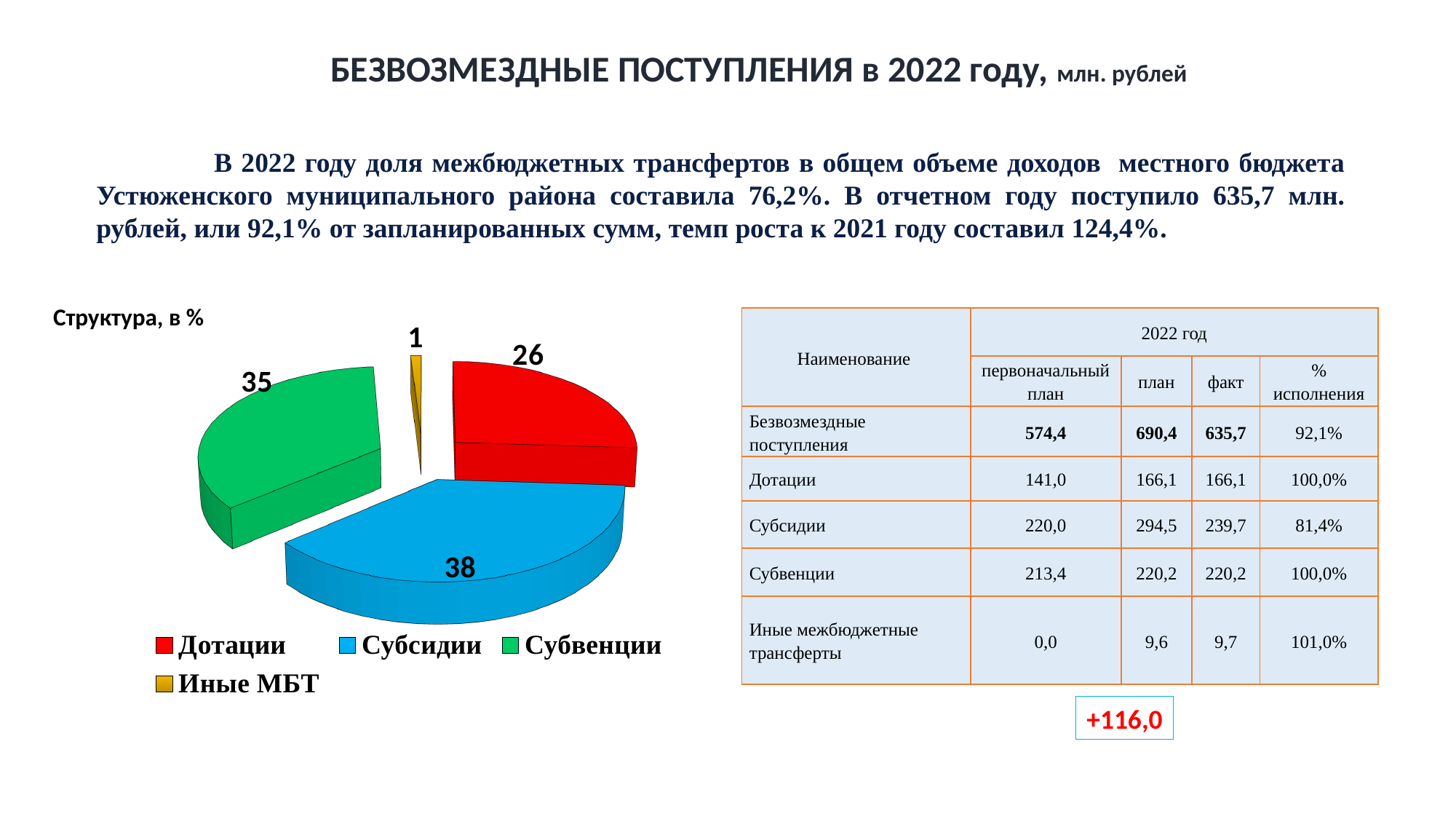
What kind of chart is shown under the heading "Структура, в %"? pie chart In the pie chart "Структура, в %", what is the difference between the values for Субсидии and Дотации? 12 In the pie chart "Структура, в %", which category has the smallest slice? Иные МБТ In the pie chart "Структура, в %", what share of the pie does Субвенции represent? 35% In the pie chart "Структура, в %", which is larger: Субвенции or Дотации? Субвенции In the pie chart "Структура, в %", what is the value for Субсидии? 38 In the pie chart "Структура, в %", what colour is the Субсидии slice? blue In the pie chart "Структура, в %", what is the value for Субвенции? 35 In the pie chart "Структура, в %", which category has the largest slice? Субсидии In the pie chart "Структура, в %", what is the value for Иные МБТ? 1 In the pie chart "Структура, в %", what is the value for Дотации? 26 How many slices does the pie chart "Структура, в %" have? 4